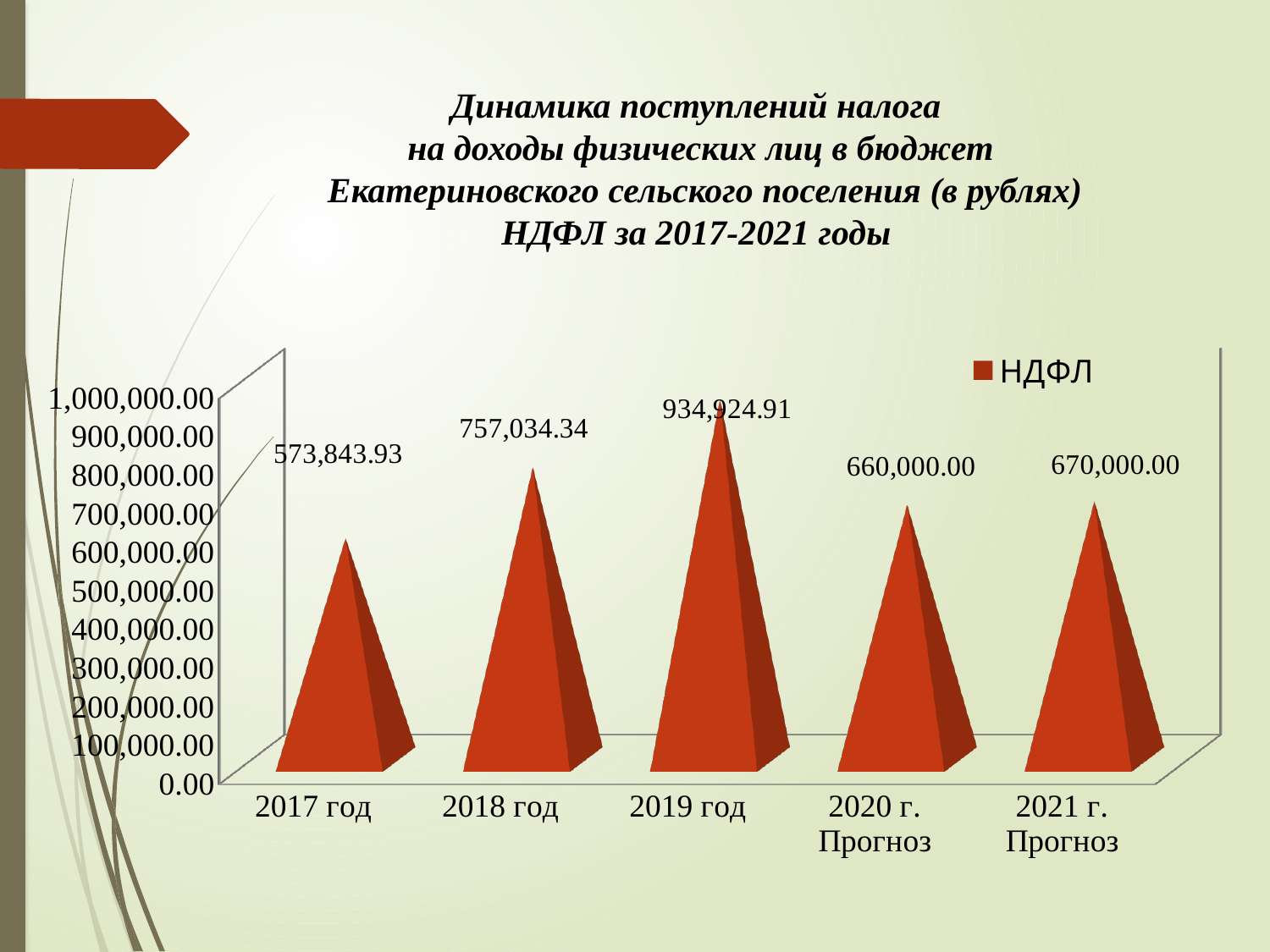
What is the forecast value for 2021 г. Прогноз? 670,000.00 Which year has the highest value? 2019 год Which is larger, the value for 2018 год or the value for 2020 г. Прогноз? 2018 год How many categories are shown on the x axis? 5 Is the value for 2019 год greater or less than 900,000.00? greater Which year has the lowest value? 2017 год What kind of chart is shown on the slide? bar chart How many series does the legend list? 1 What is the difference between the forecast values for 2021 г. Прогноз and 2020 г. Прогноз? 10,000.00 What is the difference between the values for 2019 год and 2018 год? 177,890.57 What is the value for 2017 год? 573,843.93 What is the value for 2019 год? 934,924.91